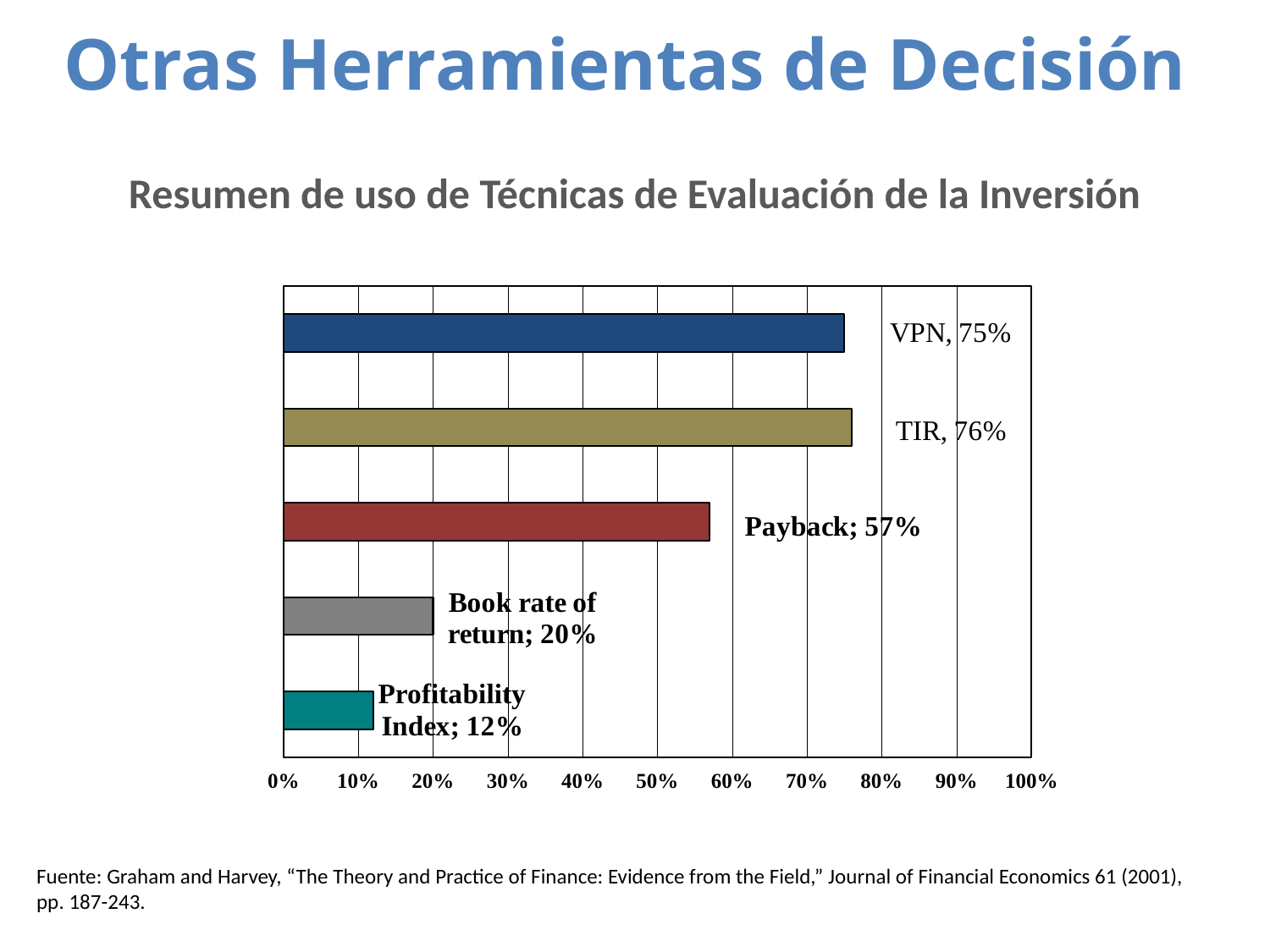
What kind of chart is shown on the slide? Bar chart What is the difference between the values for Book rate of return and Profitability Index? 8% Which category has the lowest value? Profitability Index Which is larger, the value for Payback or the value for Book rate of return? Payback What is the value for Payback? 57% What is the difference between the values for VPN and Payback? 18% What is the value for Profitability Index? 12% Which category has the highest value? TIR What is the value for VPN? 75% Is the value for Payback greater or less than 50%? greater How many categories are shown in the chart? 5 What is the value for Book rate of return? 20%